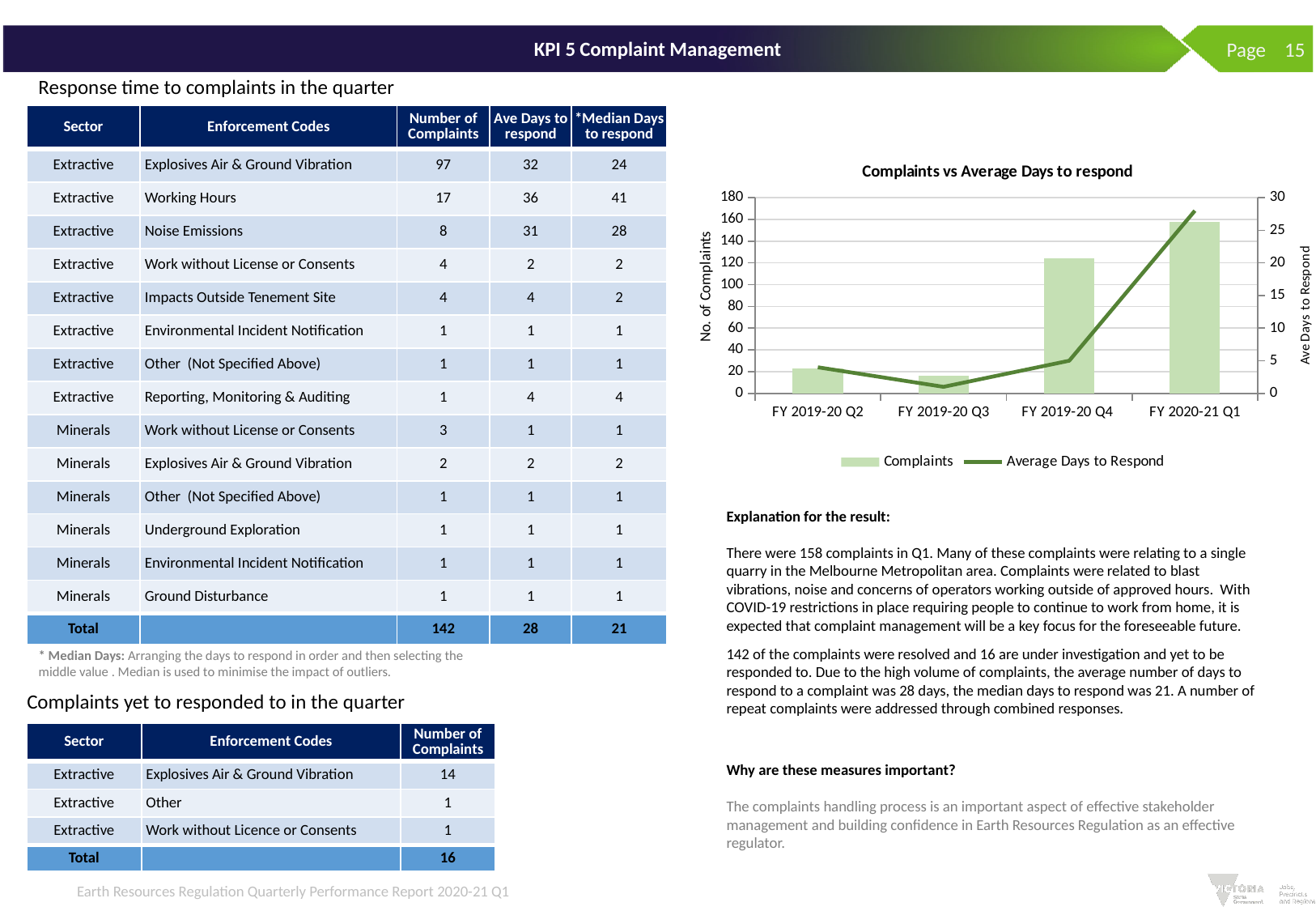
How many quarters are shown on the x axis of the chart? 4 How many series does the chart's legend list? 2 Is the number of complaints for FY 2019-20 Q2 greater or less than 40? less Which quarter has the highest number of complaints in the chart? FY 2020-21 Q1 Is the number of complaints for FY 2019-20 Q4 greater or less than 100? greater Is the number of complaints for FY 2020-21 Q1 greater or less than 140? greater Which quarter has more complaints, FY 2019-20 Q4 or FY 2020-21 Q1? FY 2020-21 Q1 What is the label of the right-hand vertical axis of the chart? Ave Days to Respond Which quarter has the lowest number of complaints in the chart? FY 2019-20 Q3 What is the title of the chart on the slide? Complaints vs Average Days to respond Does the Average Days to Respond line rise or fall from FY 2019-20 Q4 to FY 2020-21 Q1? rise